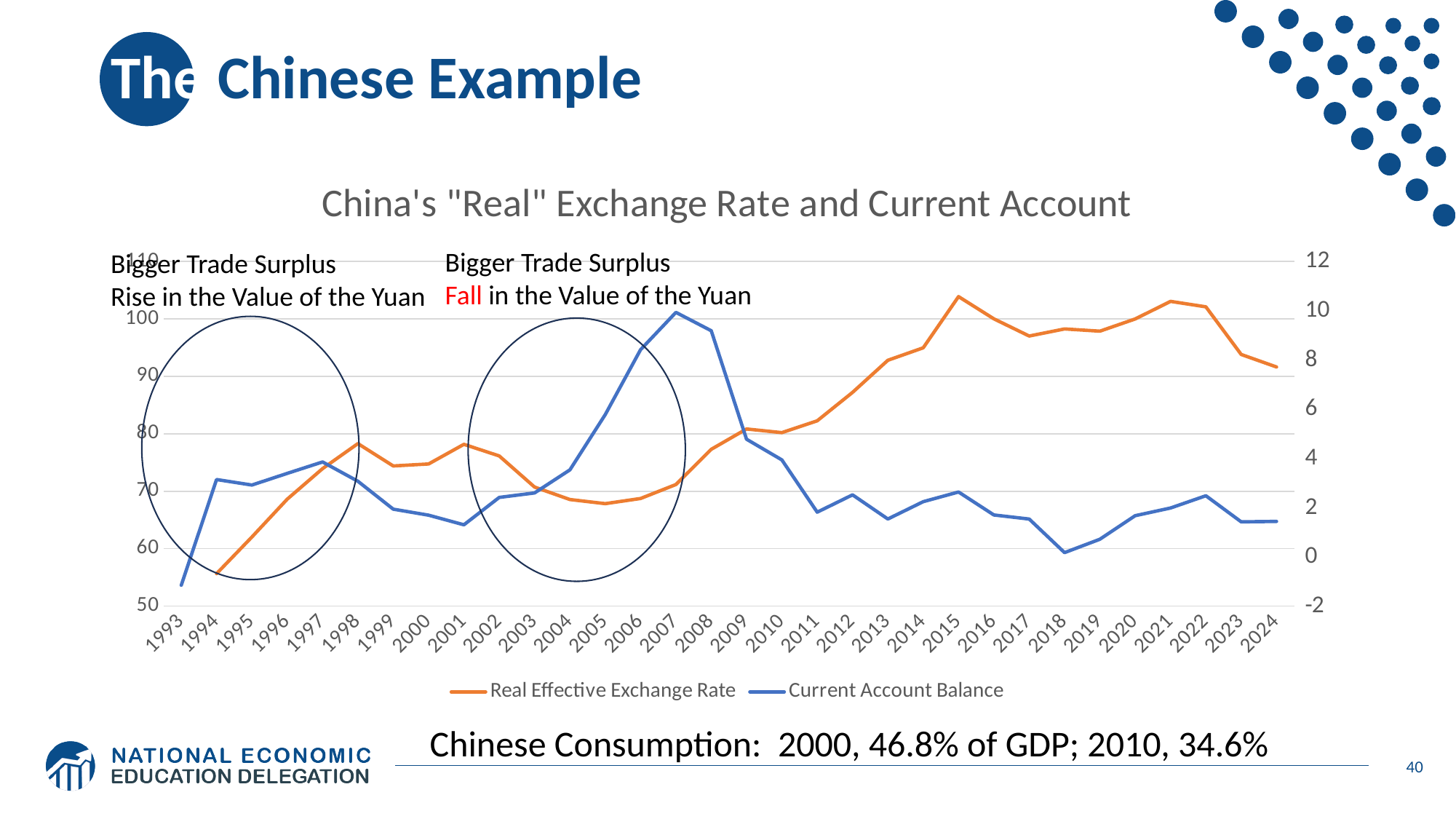
In which year does the Current Account Balance reach its highest value? 2007 Which two series are listed in the chart's legend? Real Effective Exchange Rate and Current Account Balance In which year is the Real Effective Exchange Rate at its lowest? 1994 Does the Real Effective Exchange Rate rise or fall between 2005 and 2015? rise What is the title of the chart? China's "Real" Exchange Rate and Current Account How many series does the chart's legend list? 2 Which year has the larger Current Account Balance, 2007 or 2018? 2007 How many years are shown along the x axis of the chart? 32 In which year is the Current Account Balance at its lowest? 1993 Is the Real Effective Exchange Rate in 2015 greater or less than 100 on the left axis? greater What kind of chart is shown on the slide? line chart Is the Current Account Balance in 2007 greater or less than 8 on the right axis? greater